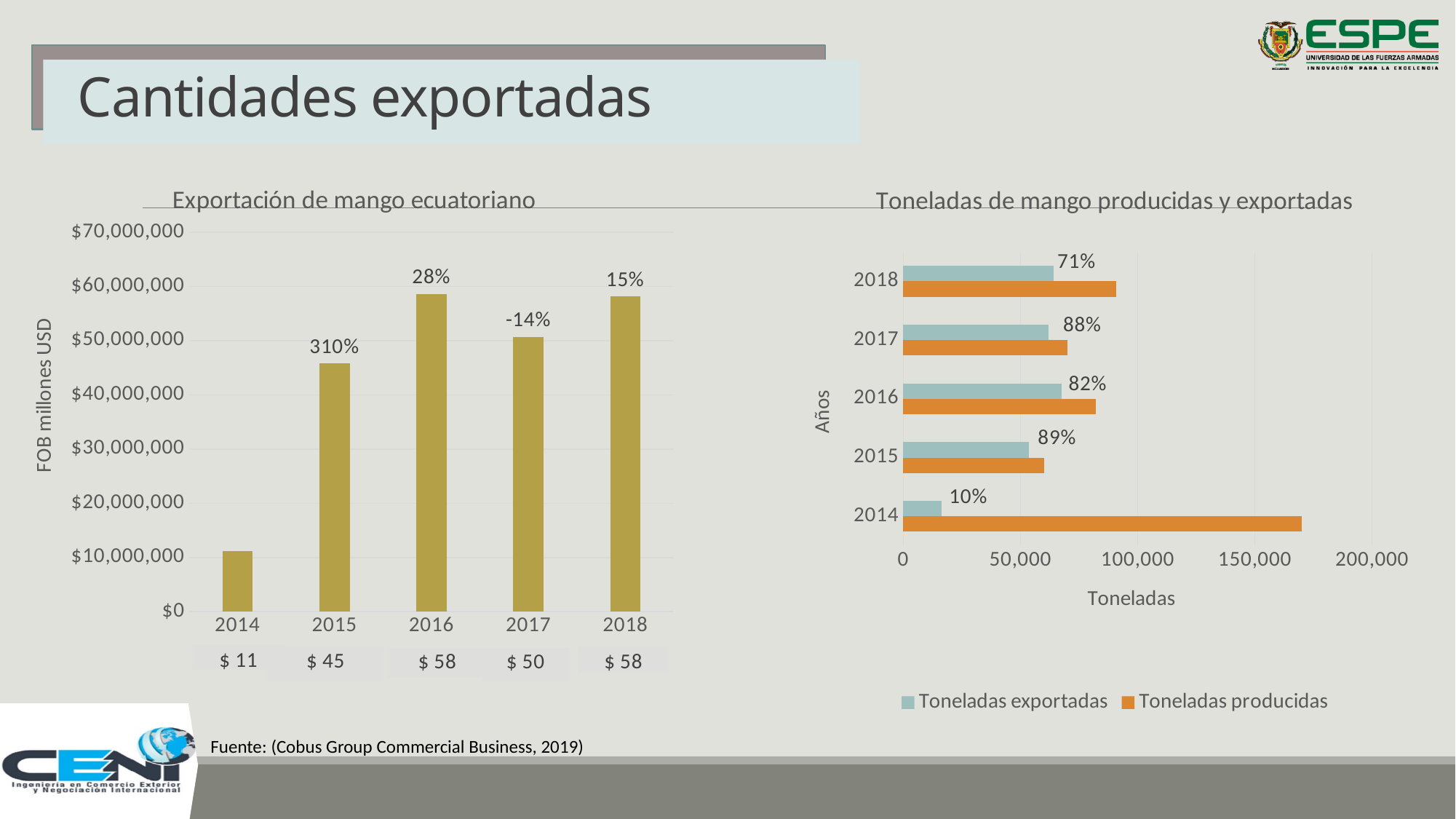
In the chart titled 'Exportación de mango ecuatoriano', what is the label of the vertical axis? FOB millones USD In the chart titled 'Exportación de mango ecuatoriano', how many years are shown on the x axis? 5 In the chart titled 'Toneladas de mango producidas y exportadas', what percentage label is shown for 2015? 89% In the chart titled 'Exportación de mango ecuatoriano', what percentage label is shown above the bar for 2017? -14% In the chart titled 'Toneladas de mango producidas y exportadas', which year has the highest value for Toneladas producidas? 2014 In the chart titled 'Toneladas de mango producidas y exportadas', is the value of Toneladas producidas for 2014 greater or less than 150,000? greater In the chart titled 'Toneladas de mango producidas y exportadas', what percentage label is shown for 2014? 10% In the chart titled 'Exportación de mango ecuatoriano', which year has the lowest bar? 2014 In the chart titled 'Exportación de mango ecuatoriano', what percentage label is shown above the bar for 2015? 310% In the chart titled 'Toneladas de mango producidas y exportadas', how many series does the legend list? 2 In the chart titled 'Exportación de mango ecuatoriano', what value does the data table below the chart show for 2014? $ 11